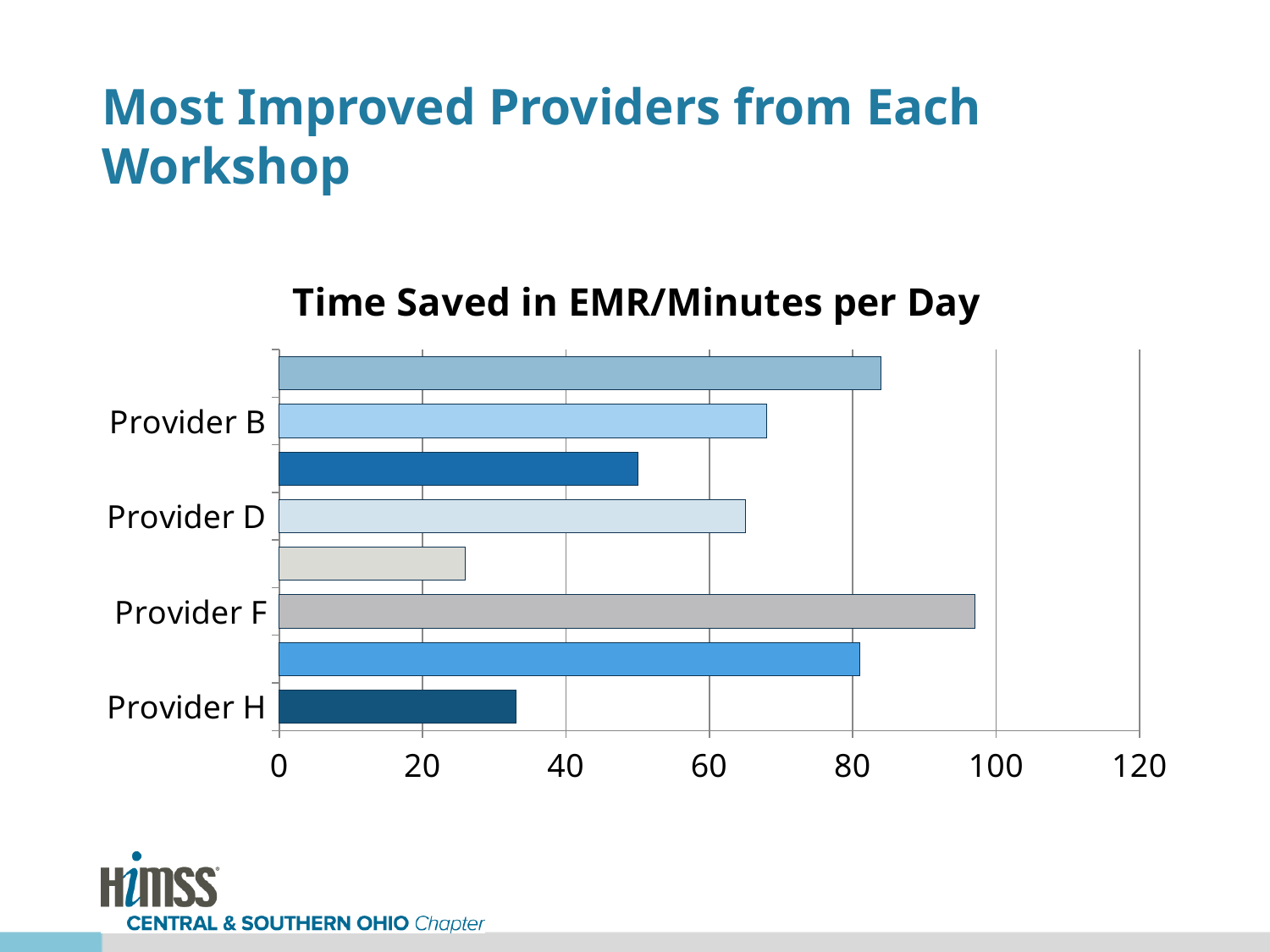
Is the value for Provider B greater or less than 60? greater How many bars are plotted in the chart? 8 Which is larger, the value for Provider D or the value for Provider F? Provider F What kind of chart is shown on the slide? bar chart Which is larger, the value for Provider F or the value for Provider H? Provider F Which is larger, the value for Provider B or the value for Provider H? Provider B Is the value for Provider H greater or less than 40? less Is the value for Provider D greater or less than 80? less What is the title of the chart? Time Saved in EMR/Minutes per Day Which provider has the longest bar in the chart? Provider F What is the highest value shown on the horizontal axis? 120